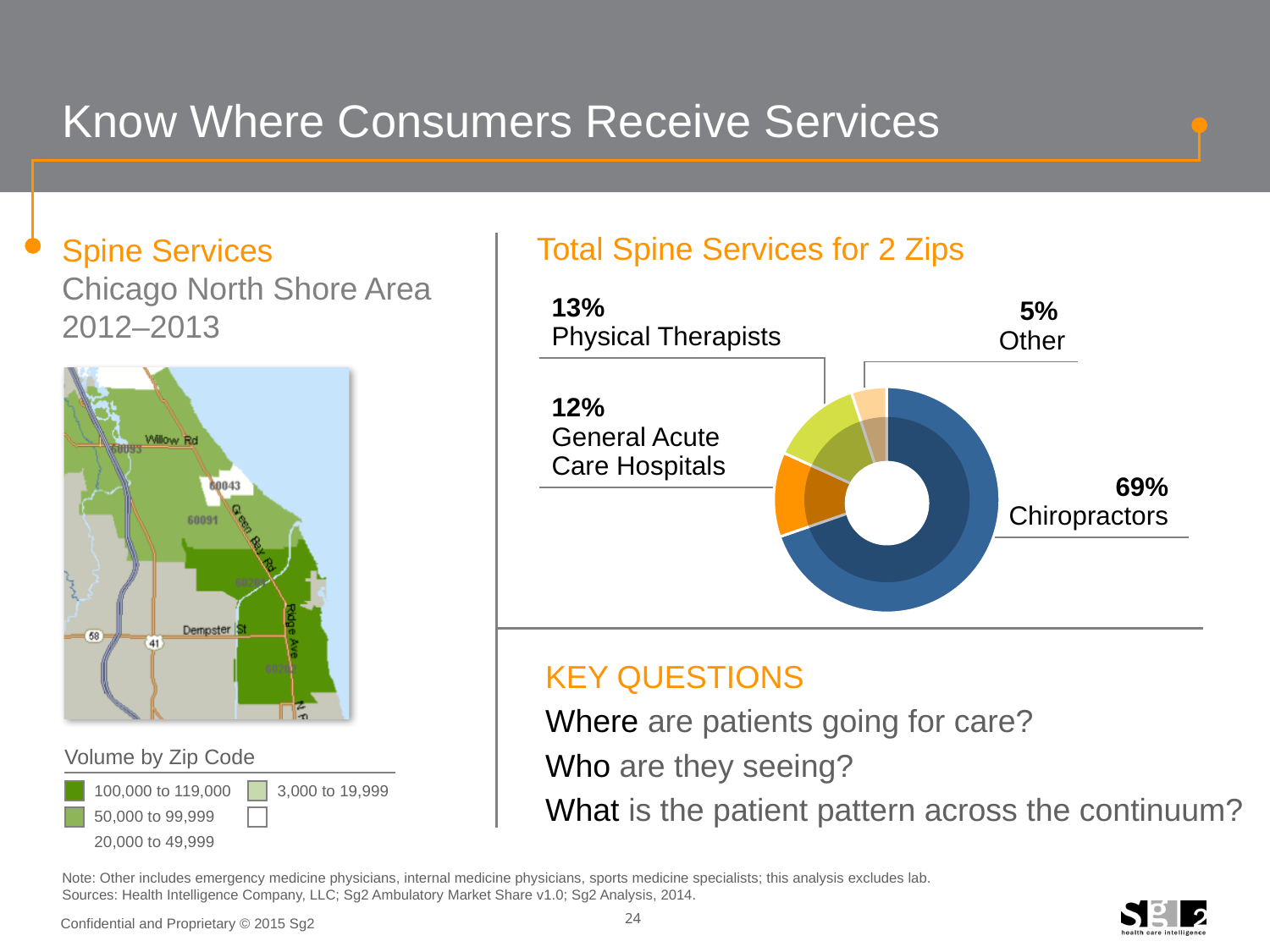
How many categories are shown in the Total Spine Services for 2 Zips chart? 4 What kind of chart is used to show Total Spine Services for 2 Zips? Pie (donut) chart What share of total spine services for the 2 zips goes to General Acute Care Hospitals? 12% Which has a larger share of total spine services: General Acute Care Hospitals or Other? General Acute Care Hospitals What share of total spine services for the 2 zips goes to Physical Therapists? 13% What share of total spine services for the 2 zips goes to Chiropractors? 69% What share of total spine services for the 2 zips goes to Other? 5% Which category has the smallest share in the Total Spine Services for 2 Zips chart? Other What is the title of the chart on the right side of the slide? Total Spine Services for 2 Zips What is the difference in percentage points between the Chiropractors share and the Physical Therapists share? 56 Which category has the largest share in the Total Spine Services for 2 Zips chart? Chiropractors What is the difference in percentage points between the Physical Therapists share and the General Acute Care Hospitals share? 1